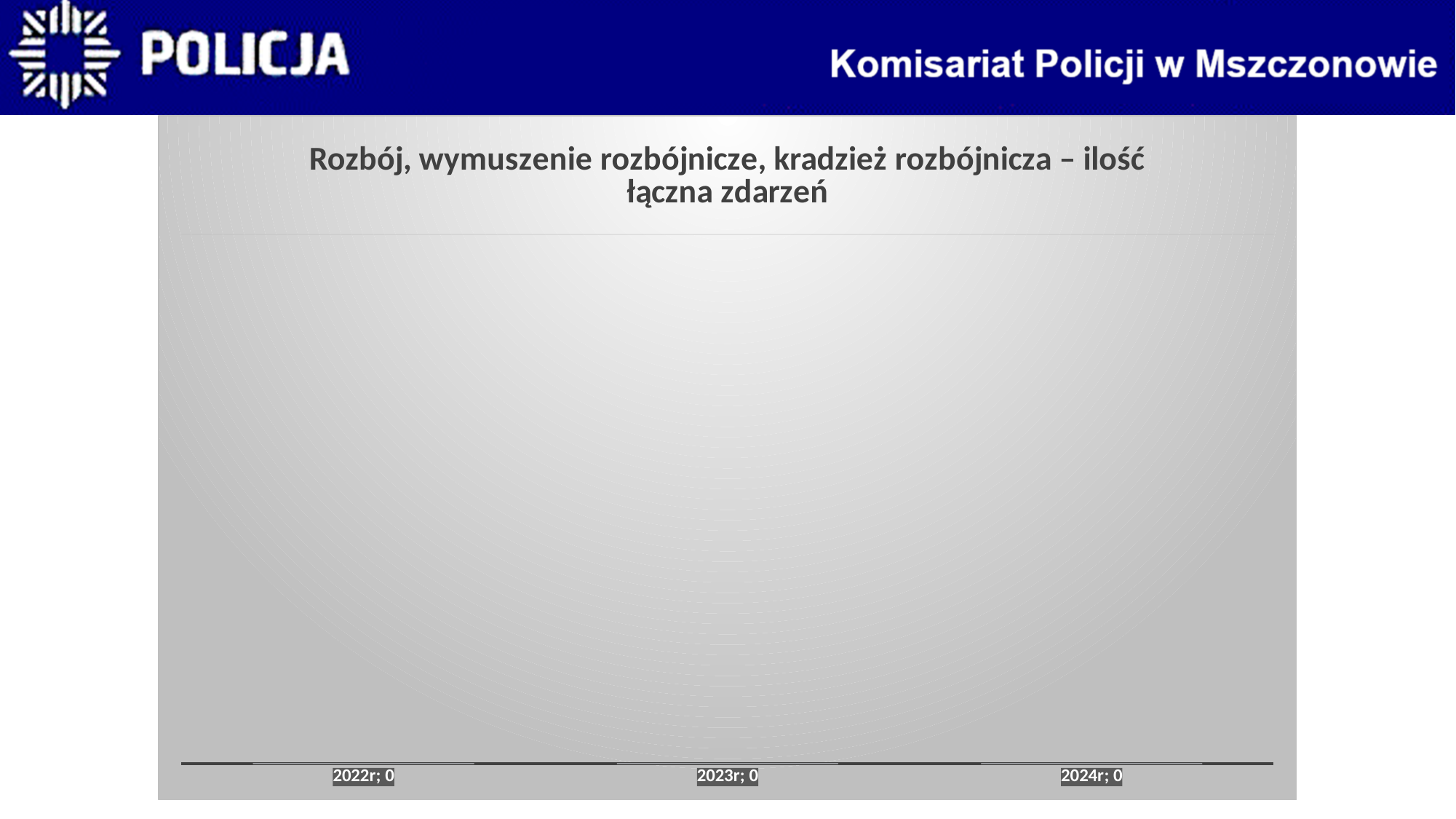
Do the values rise, fall, or stay the same from 2022r to 2024r? stay the same What is the difference between the values for 2023r and 2022r? 0 What is the title of the chart? Rozbój, wymuszenie rozbójnicze, kradzież rozbójnicza – ilość łączna zdarzeń What is the value shown for 2023r? 0 Which years are labelled on the chart's x axis? 2022r, 2023r, 2024r What is the value shown for 2022r? 0 What is the value shown for 2024r? 0 How many categories (years) are shown on the chart? 3 Is the value for 2023r greater than 0? no What is the difference between the values for 2024r and 2022r? 0